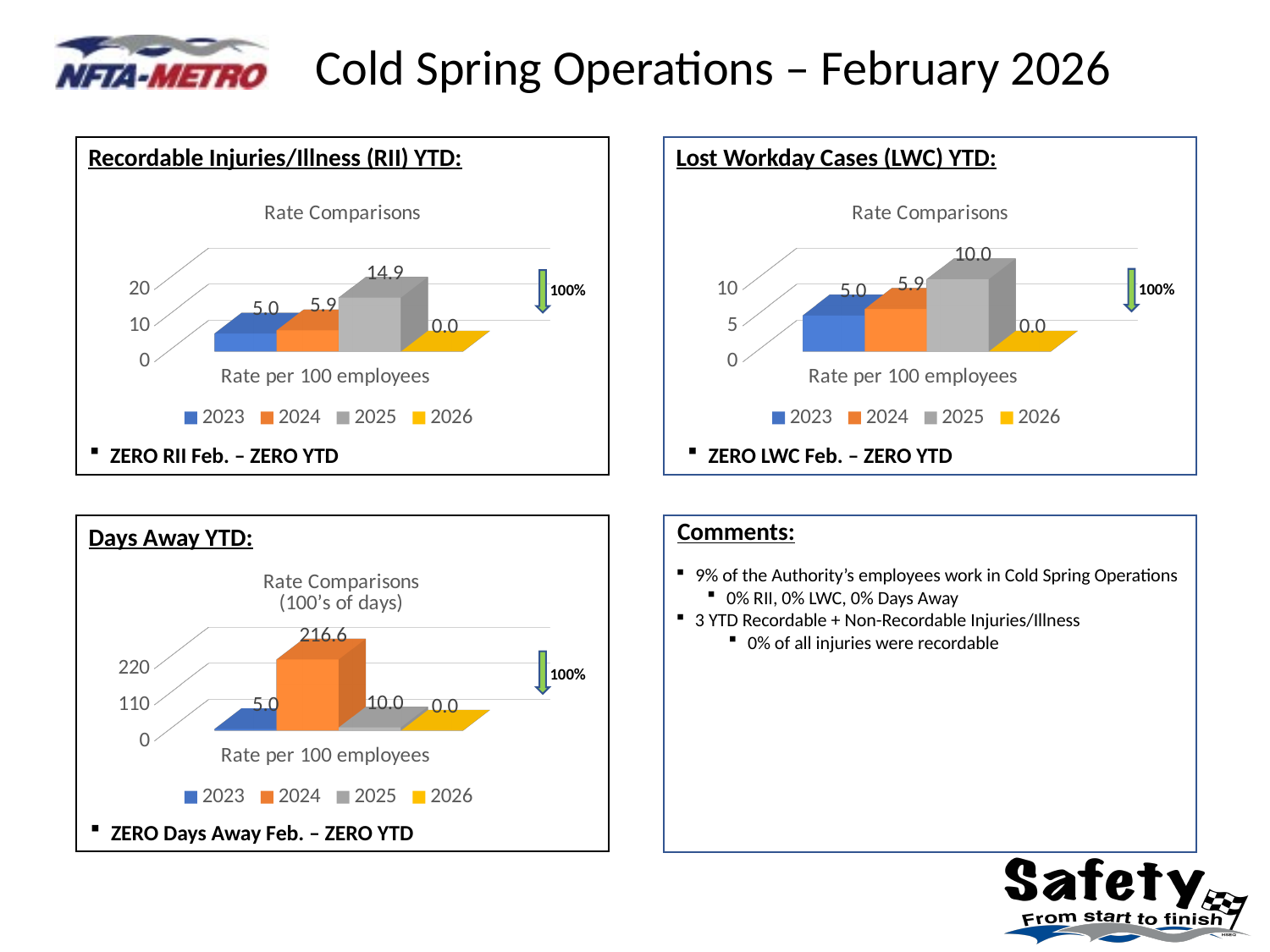
In the Lost Workday Cases (LWC) YTD chart, which year has the lowest value? 2026 In the Recordable Injuries/Illness (RII) YTD chart, which year has the highest value? 2025 In the Days Away YTD chart, what is the value for 2024? 216.6 In the Recordable Injuries/Illness (RII) YTD chart, what is the value for 2025? 14.9 In the Recordable Injuries/Illness (RII) YTD chart, what is the difference between the 2025 and 2024 values? 9.0 In the Days Away YTD chart, which year has the highest value? 2024 What is the title of the chart in the Recordable Injuries/Illness (RII) YTD box? Rate Comparisons In the Lost Workday Cases (LWC) YTD chart, what is the value for 2025? 10.0 What kind of chart is the Lost Workday Cases (LWC) YTD chart? bar chart In the Days Away YTD chart, what is the difference between the 2025 and 2023 values? 5.0 In the Lost Workday Cases (LWC) YTD chart, is the value for 2024 larger or smaller than the value for 2023? larger How many series does the legend of the Days Away YTD chart list? 4